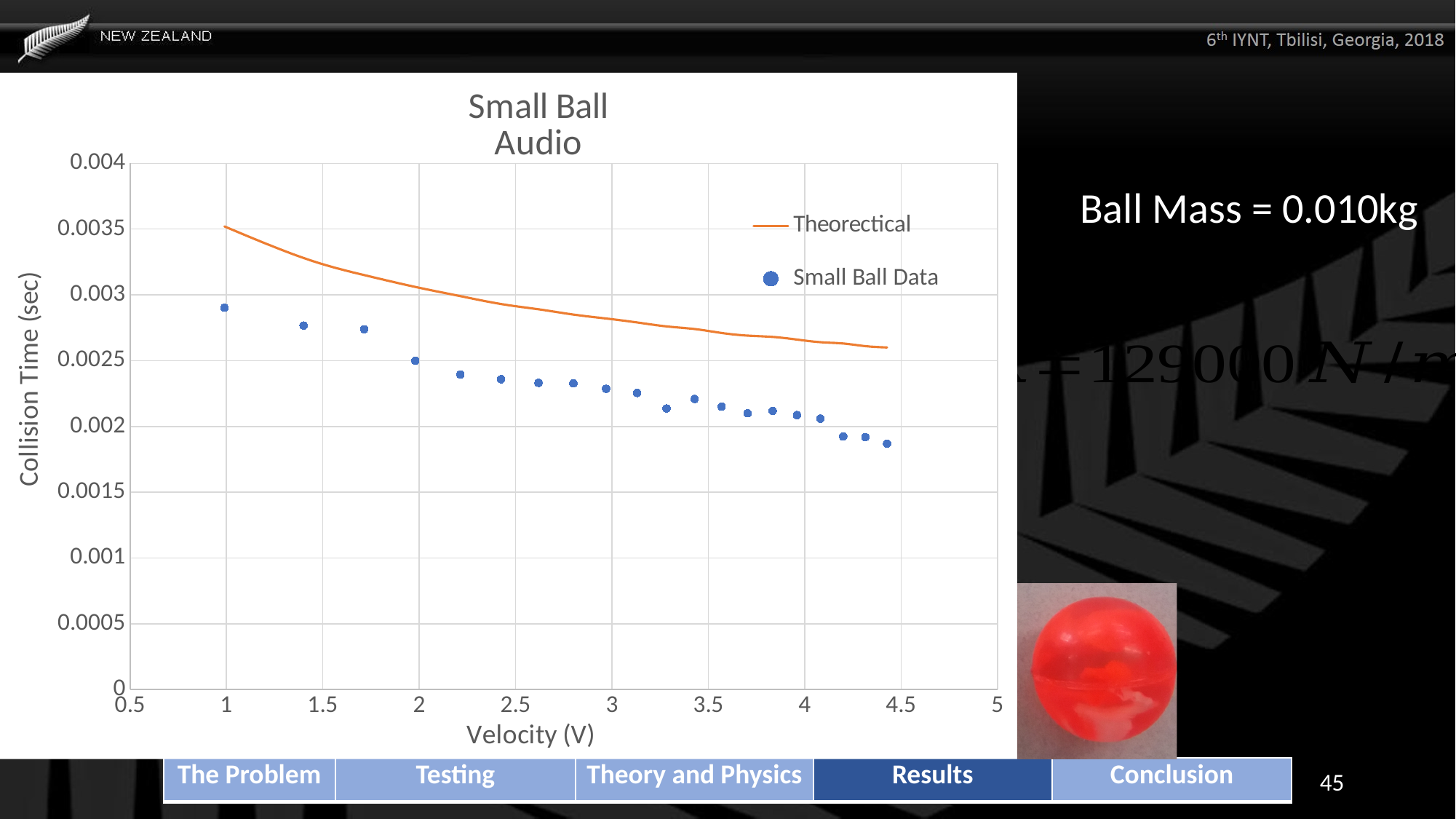
Is the Small Ball Data collision time at the highest velocity (about 4.4) greater or less than 0.002? less Is the Theorectical collision time at a velocity of about 4.4 greater or less than 0.0025? greater How many series does the legend list? 2 What kind of chart is shown on the slide? Scatter chart with a line At which velocity does the Small Ball Data series reach its highest collision time? 1 What are the two series named in the legend? Theorectical and Small Ball Data Which series has the higher collision time at a velocity of 3, Theorectical or Small Ball Data? Theorectical Is the Small Ball Data collision time at a velocity of 3 greater or less than 0.0025? less What is the title of the chart? Small Ball Audio Does the collision time rise or fall as velocity increases along the x axis? Fall